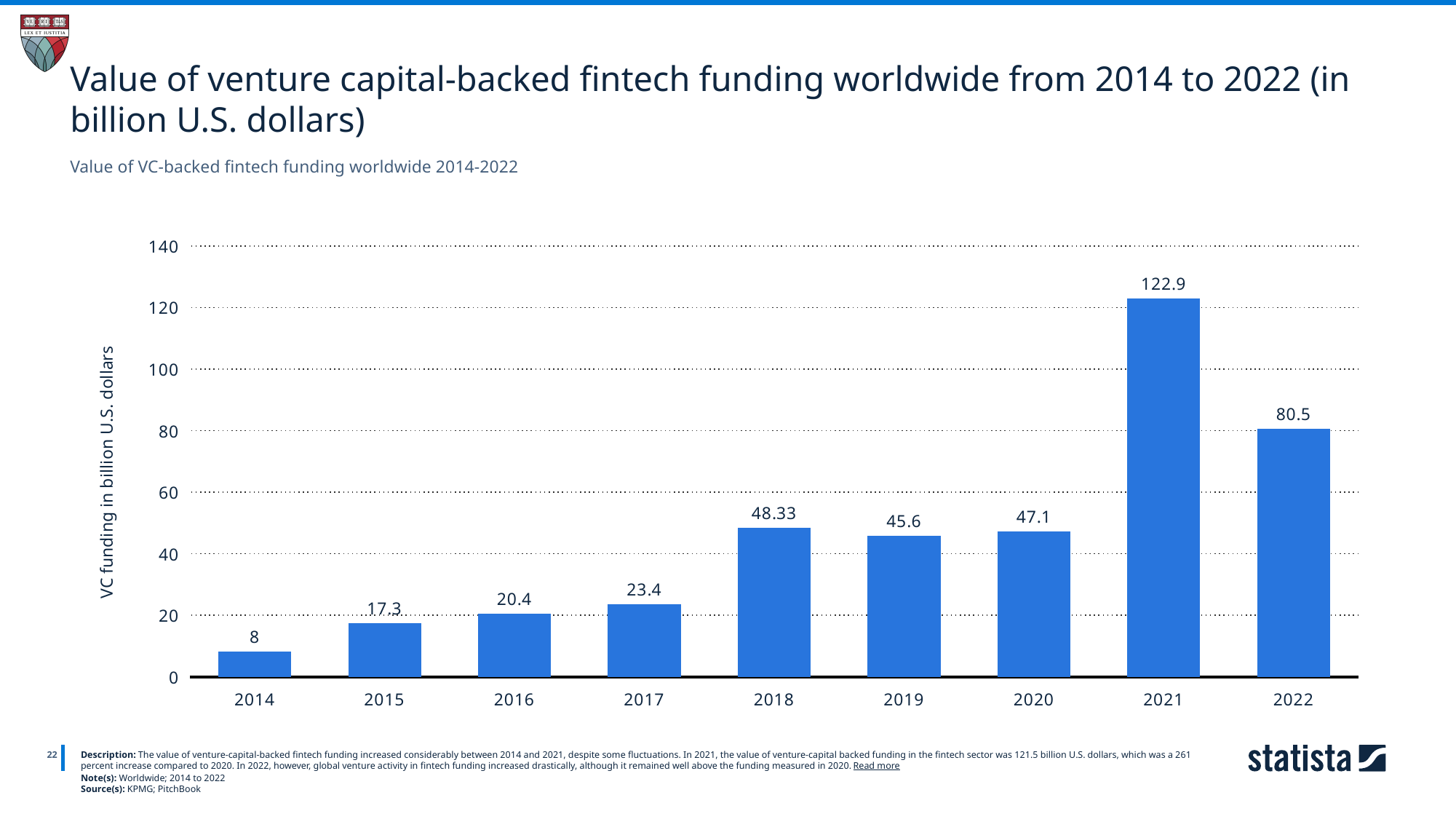
How many years are shown on the chart? 9 What is the difference between the funding values for 2020 and 2019? 1.5 What kind of chart is shown on the slide? Bar chart What was the value of VC-backed fintech funding in 2014? 8 What was the value of VC-backed fintech funding in 2021? 122.9 Is the value for 2022 greater or less than 100? less Which year had higher VC-backed fintech funding, 2017 or 2016? 2017 What was the value of VC-backed fintech funding in 2018? 48.33 What is the label of the vertical axis? VC funding in billion U.S. dollars What is the difference between the funding values for 2021 and 2022? 42.4 Which year had the lowest VC-backed fintech funding? 2014 Which year had the highest VC-backed fintech funding? 2021